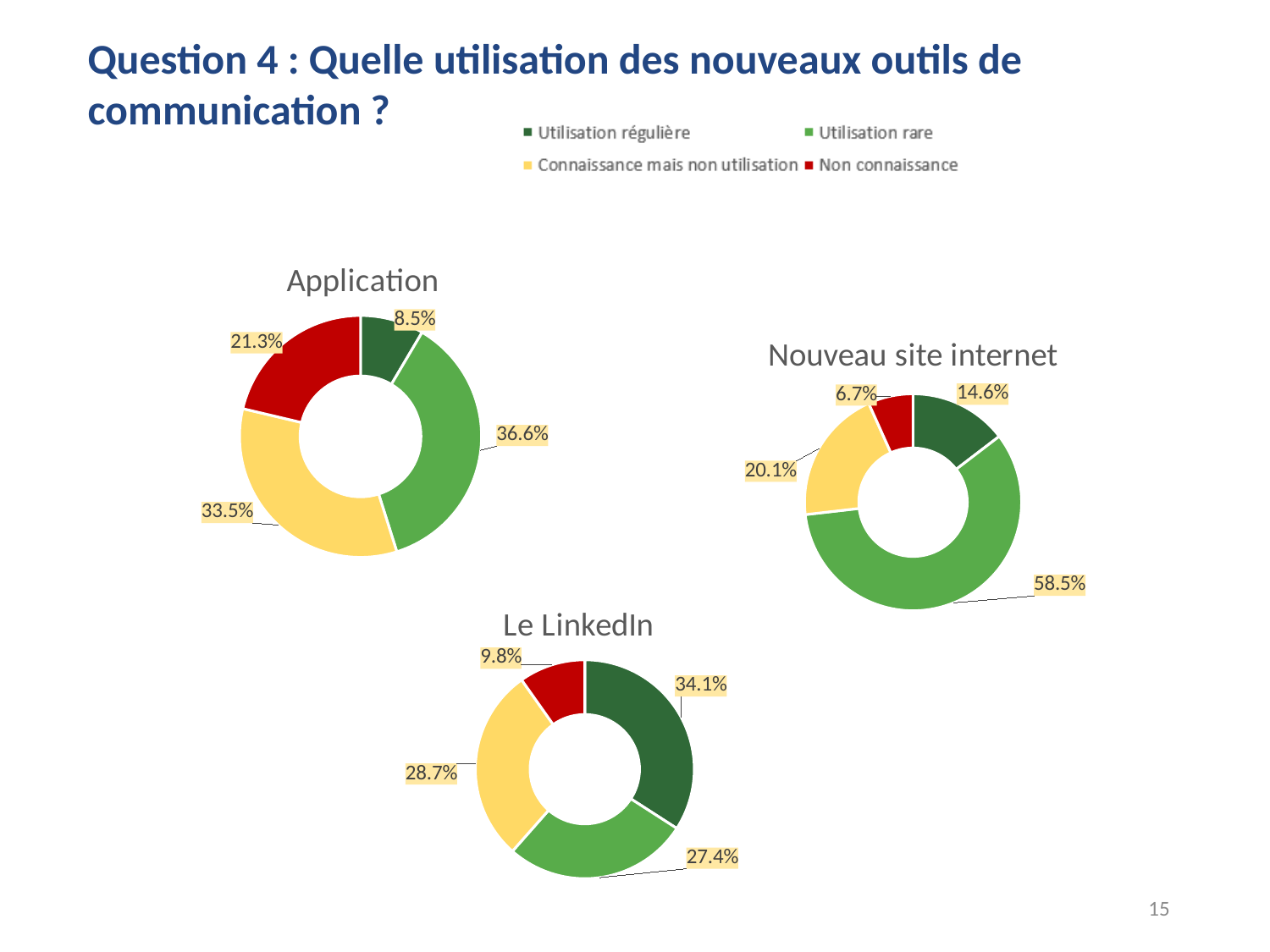
Which is larger: the Utilisation régulière share in the Le LinkedIn chart or in the Application chart? Le LinkedIn In the Application chart, what share is labelled for Non connaissance (red)? 21.3% What kind of chart is the Application chart? Doughnut chart In the Application chart, what share is labelled for Utilisation rare (light green)? 36.6% In the Nouveau site internet chart, what share is labelled for Utilisation régulière (dark green)? 14.6% In the Nouveau site internet chart, which category has the largest share? Utilisation rare How many categories does the legend list? 4 In the Le LinkedIn chart, what share is labelled for Connaissance mais non utilisation (yellow)? 28.7% How many charts are shown on the slide? 3 In the Le LinkedIn chart, which category has the largest share? Utilisation régulière In the Application chart, which category has the smallest share? Utilisation régulière In the Nouveau site internet chart, what is the difference between the Utilisation rare share and the Connaissance mais non utilisation share? 38.4%